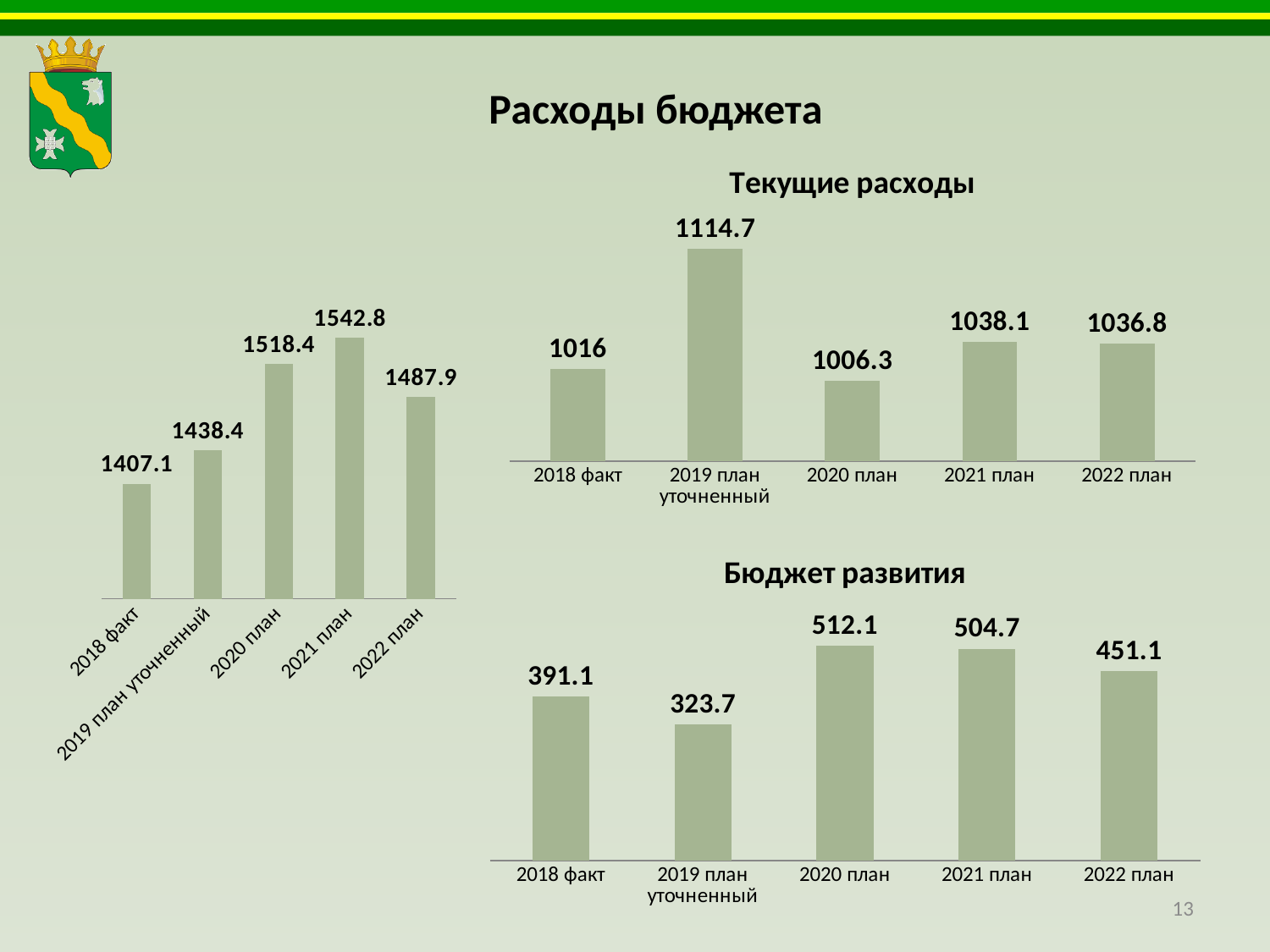
In the 'Бюджет развития' chart, what is the difference between the values for 2020 план and 2019 план уточненный? 188.4 In the 'Текущие расходы' chart, how many categories are shown? 5 What kind of chart is the 'Текущие расходы' chart? Bar chart In the left chart, which category has the lowest value? 2018 факт In the 'Текущие расходы' chart, what is the value for 2019 план уточненный? 1114.7 In the 'Бюджет развития' chart, which category has the highest value? 2020 план In the 'Бюджет развития' chart, which is larger: the value for 2018 факт or 2019 план уточненный? 2018 факт What is the title of the bottom-right chart? Бюджет развития In the left chart (untitled, under 'Расходы бюджета'), what is the value for 2021 план? 1542.8 In the left chart, what is the difference between the values for 2021 план and 2018 факт? 135.7 In the 'Текущие расходы' chart, which category has the lowest value? 2020 план In the 'Бюджет развития' chart, what is the value for 2022 план? 451.1